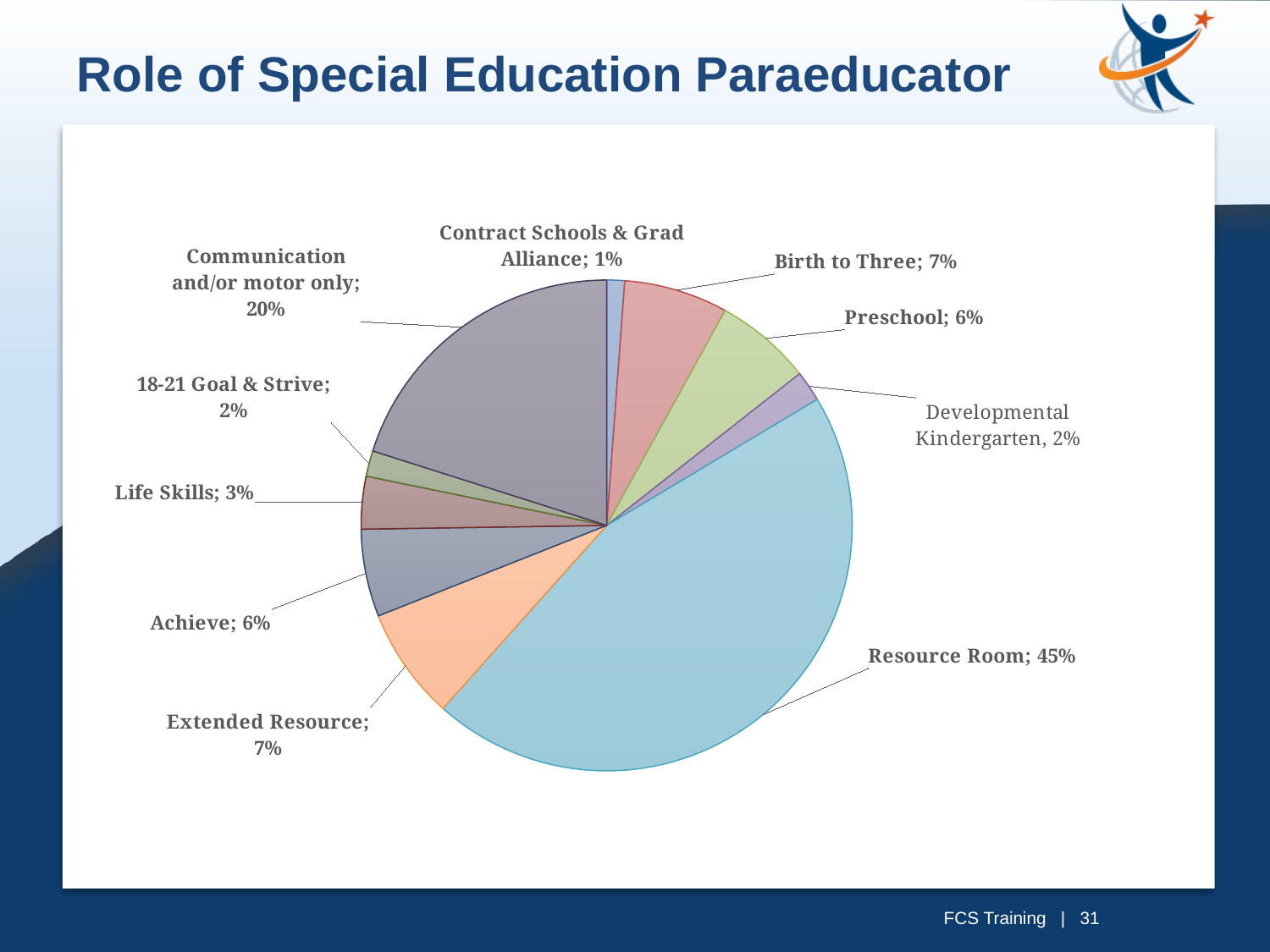
Which category has the largest slice of the pie? Resource Room What is the value shown for Life Skills? 3% How many categories are shown in the pie chart? 10 What share of the pie does Resource Room represent? 45% Which category has the smallest slice of the pie? Contract Schools & Grad Alliance What is the value shown for Communication and/or motor only? 20% What kind of chart is shown on the slide? Pie chart What is the value shown for Developmental Kindergarten? 2% What is the value shown for Birth to Three? 7% What is the difference between the Resource Room share and the Communication and/or motor only share? 25% What is the title of the slide containing the pie chart? Role of Special Education Paraeducator Which is larger, the share for Preschool or the share for Birth to Three? Birth to Three